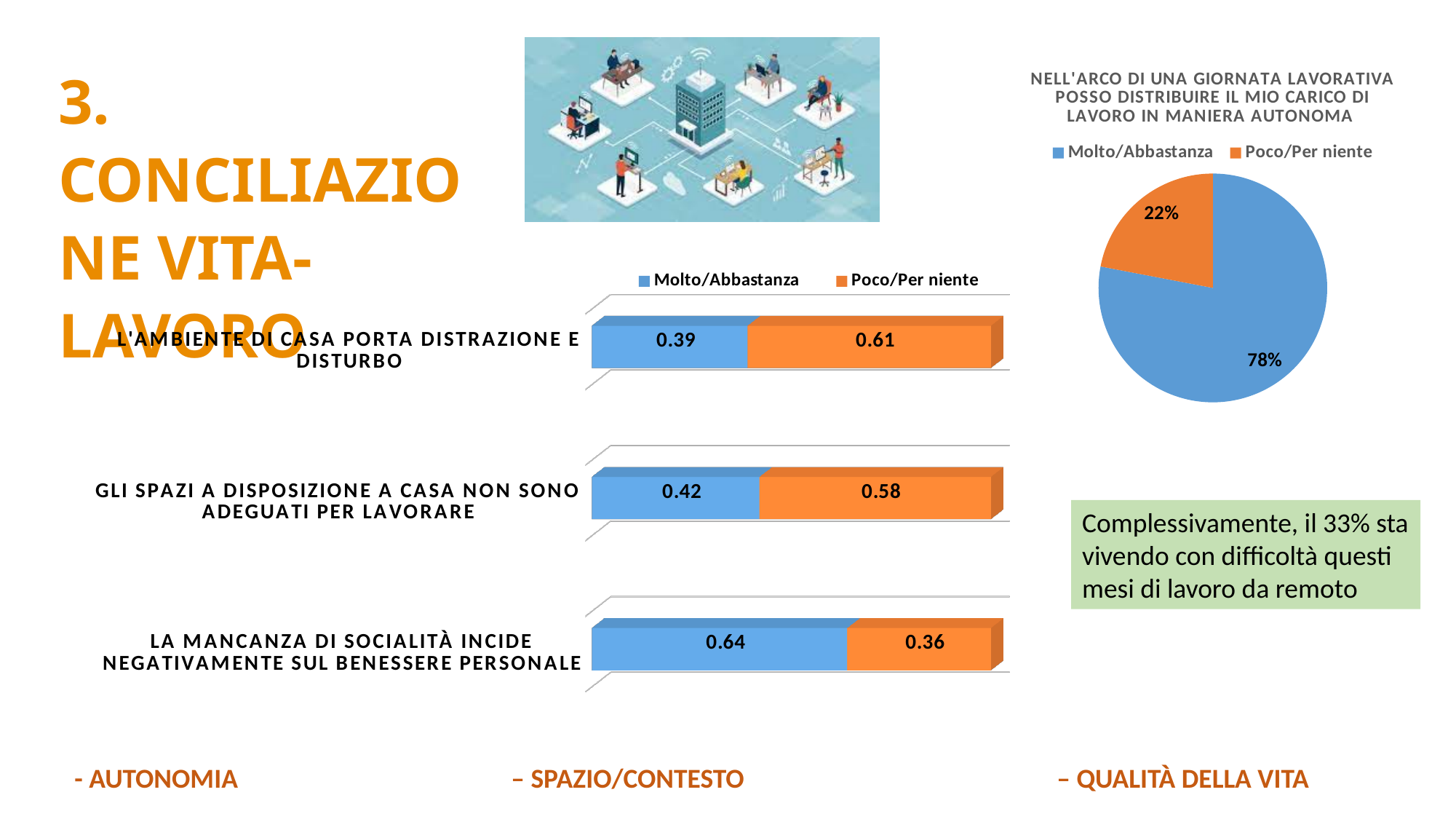
In the stacked bar chart in the centre of the slide, what is the Poco/Per niente value for "L'ambiente di casa porta distrazione e disturbo"? 0.61 In the stacked bar chart in the centre of the slide, is the Molto/Abbastanza value larger for "Gli spazi a disposizione a casa non sono adeguati per lavorare" or for "L'ambiente di casa porta distrazione e disturbo"? Gli spazi a disposizione a casa non sono adeguati per lavorare In the stacked bar chart in the centre of the slide, what is the difference between the Poco/Per niente and Molto/Abbastanza values for "L'ambiente di casa porta distrazione e disturbo"? 0.22 In the stacked bar chart in the centre of the slide, what is the Molto/Abbastanza value for "Gli spazi a disposizione a casa non sono adeguati per lavorare"? 0.42 In the stacked bar chart in the centre of the slide, which category has the lowest Poco/Per niente value? La mancanza di socialità incide negativamente sul benessere personale In the stacked bar chart in the centre of the slide, what is the Molto/Abbastanza value for "La mancanza di socialità incide negativamente sul benessere personale"? 0.64 What kind of chart is the chart titled "Nell'arco di una giornata lavorativa posso distribuire il mio carico di lavoro in maniera autonoma"? Pie chart How many categories does the stacked bar chart in the centre of the slide show? 3 In the stacked bar chart in the centre of the slide, which category has the highest Molto/Abbastanza value? La mancanza di socialità incide negativamente sul benessere personale In the pie chart titled "Nell'arco di una giornata lavorativa posso distribuire il mio carico di lavoro in maniera autonoma", what share is Poco/Per niente? 22% In the pie chart titled "Nell'arco di una giornata lavorativa posso distribuire il mio carico di lavoro in maniera autonoma", which slice is the largest? Molto/Abbastanza How many series does the legend of the stacked bar chart in the centre of the slide list? 2